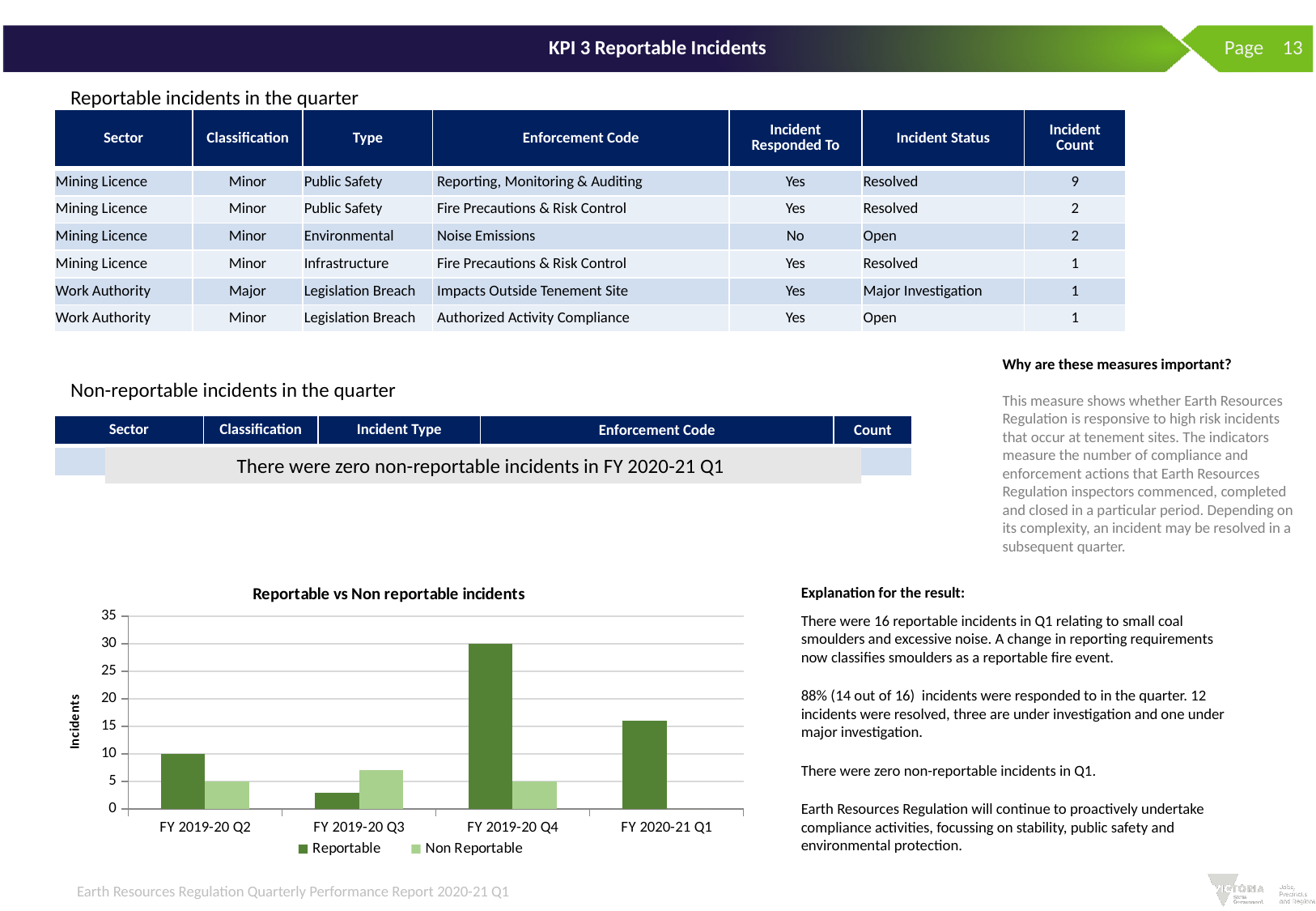
In which quarter is the Reportable series lowest? FY 2019-20 Q3 What type of chart is shown on the slide? Bar chart What is the Reportable value for FY 2019-20 Q4 in the chart? 30 What is the difference between the Reportable values for FY 2019-20 Q4 and FY 2019-20 Q2? 20 In which quarter is the Reportable series highest? FY 2019-20 Q4 What is the Reportable value for FY 2019-20 Q2 in the chart? 10 What is the title of the chart on the slide? Reportable vs Non reportable incidents What is the Non Reportable value for FY 2019-20 Q2 in the chart? 5 How many series does the chart's legend list? 2 Is the Reportable value for FY 2020-21 Q1 greater or less than 20? less How many quarters are shown on the x axis of the chart? 4 For FY 2019-20 Q3, which is larger: Reportable or Non Reportable? Non Reportable